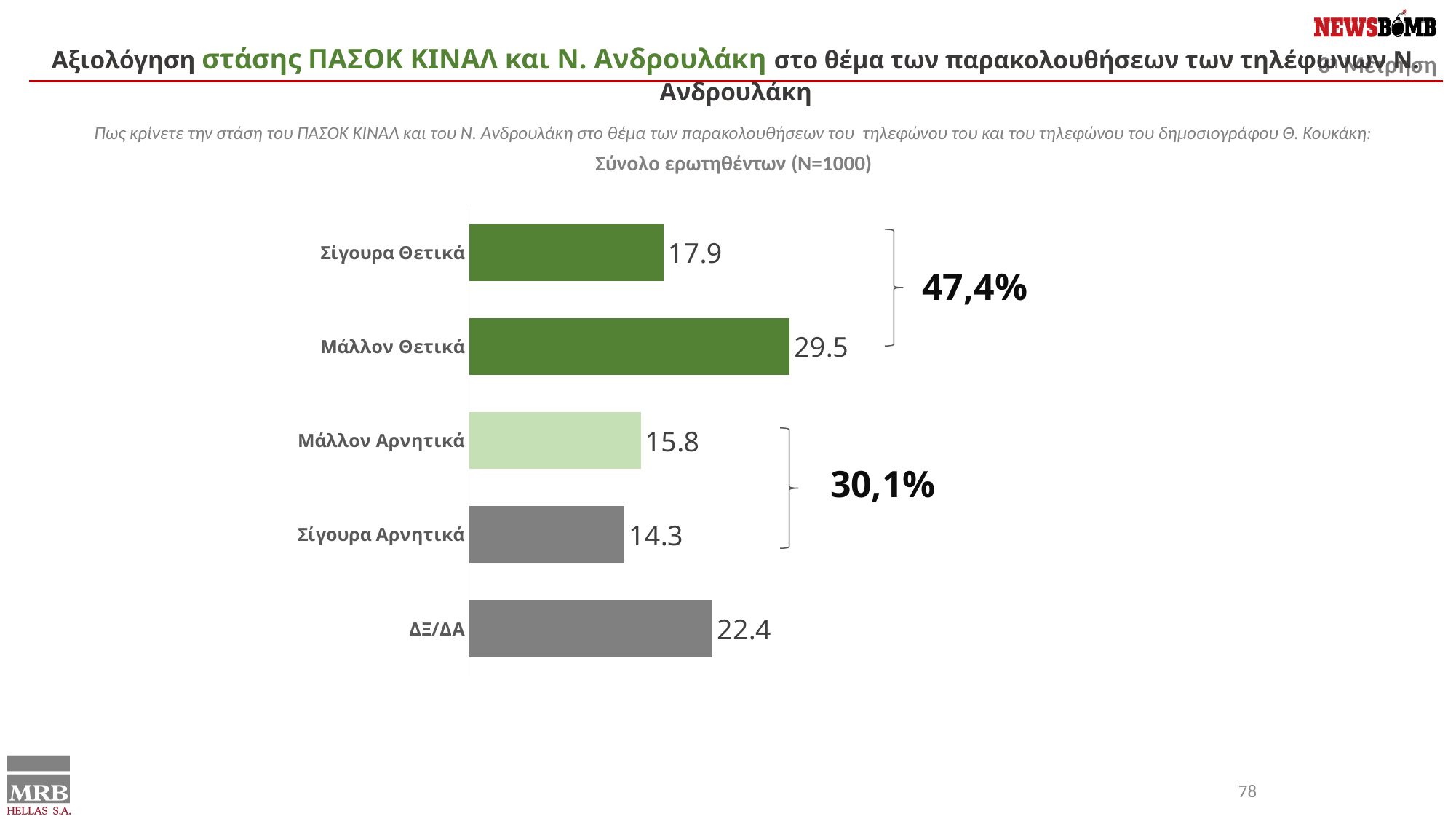
What is the value for Μάλλον Αρνητικά? 15.8 What combined percentage is shown by the bracket next to the two positive categories (Σίγουρα Θετικά and Μάλλον Θετικά)? 47,4% Which category has the highest value? Μάλλον Θετικά What is the value for Μάλλον Θετικά? 29.5 What is the value for Σίγουρα Θετικά? 17.9 Which category has the lowest value? Σίγουρα Αρνητικά Which is larger, the value for ΔΞ/ΔΑ or the value for Μάλλον Αρνητικά? ΔΞ/ΔΑ What kind of chart is shown on the slide? Bar chart What is the difference between the values for Μάλλον Θετικά and Σίγουρα Θετικά? 11.6 How many categories are shown in the chart? 5 What is the value for ΔΞ/ΔΑ? 22.4 What is the value for Σίγουρα Αρνητικά? 14.3